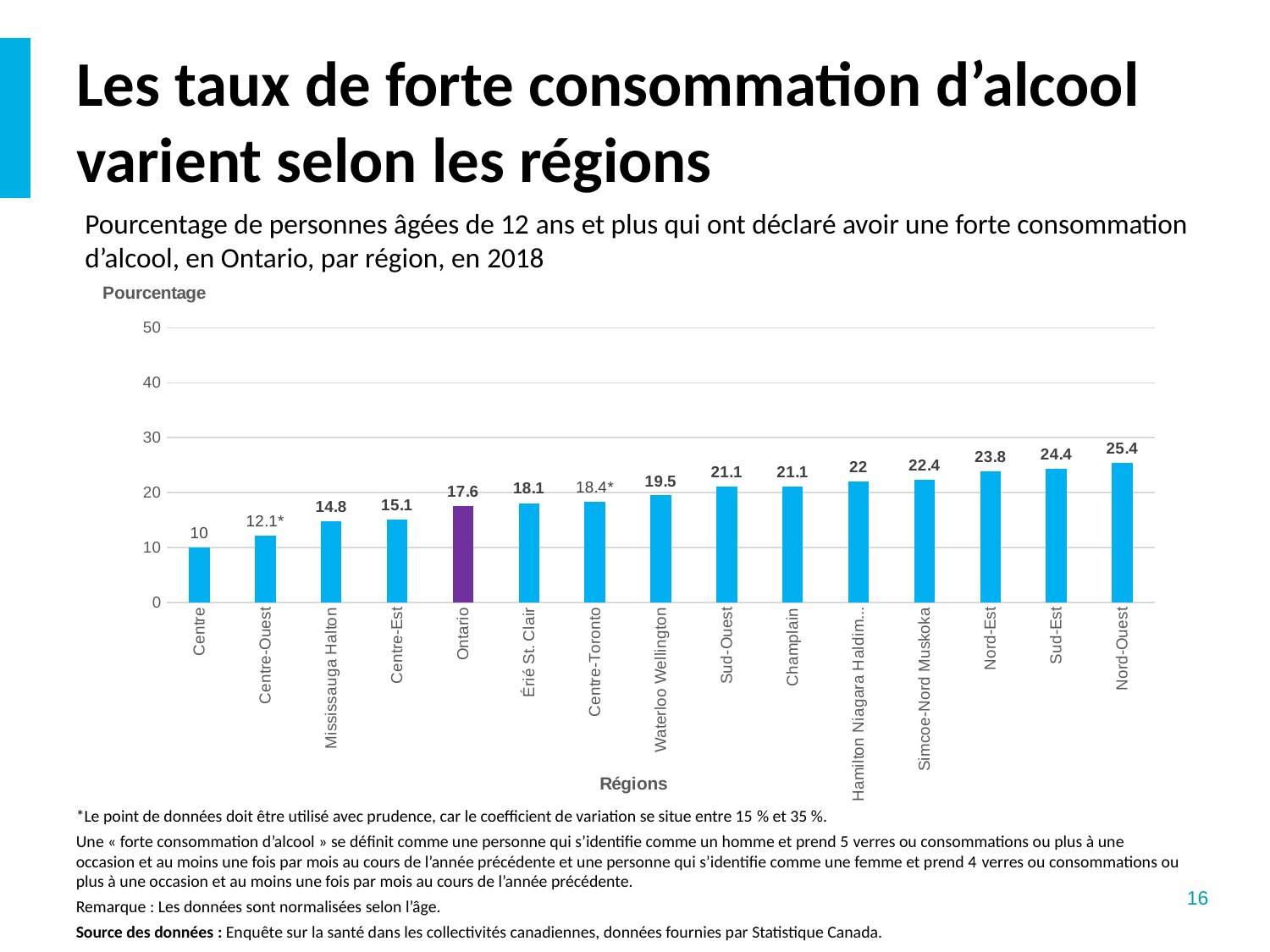
How many bars are plotted in the chart? 15 What type of chart is shown on the slide? bar chart Which region has the lowest value? Centre Which region has the highest value? Nord-Ouest What is the value for Nord-Est? 23.8 What is the value for Ontario? 17.6 Which bar is shown in a different colour (purple) from the others? Ontario Do the values generally rise or fall from left to right along the x axis? rise Which is larger, the value for Sud-Est or the value for Simcoe-Nord Muskoka? Sud-Est What is the difference between the values for Nord-Ouest and Centre? 15.4 What is the value for Centre-Ouest? 12.1* Is the value for Waterloo Wellington greater or less than 20? less